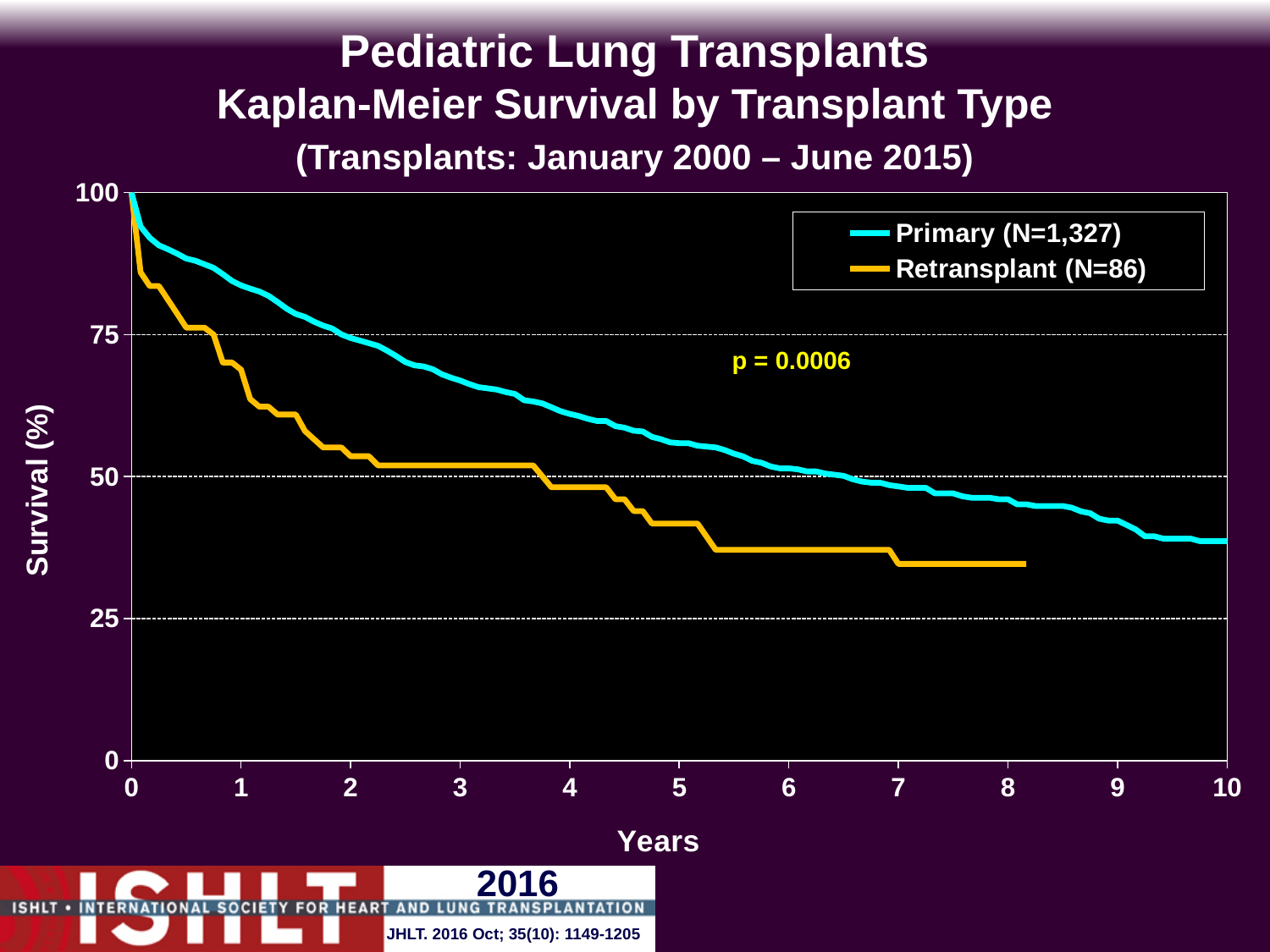
Is the survival for Primary at 10 years greater or less than 50? less What p-value is shown on the chart? p = 0.0006 How many series does the legend list? 2 Is the survival for Retransplant at 5 years greater or less than 50? less Is the survival for Retransplant at 1 year greater or less than 75? less Which series shows the lower survival across the follow-up period? Retransplant What is the N for the Retransplant series in the legend? 86 Which series has the higher survival at 5 years, Primary or Retransplant? Primary Do the survival curves rise or fall as the years increase? Fall What kind of chart is shown on the slide? Line chart